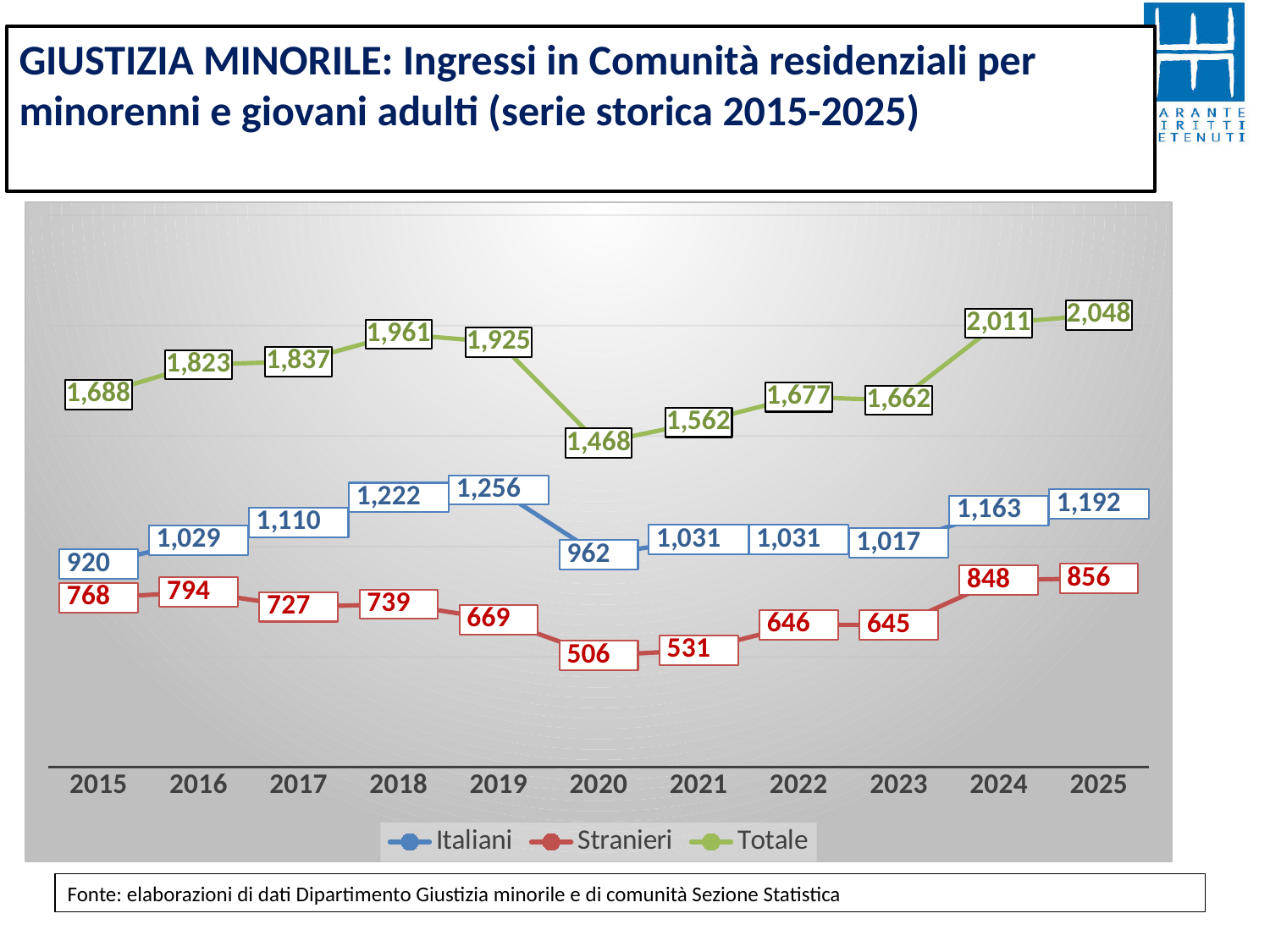
Does the Totale series rise or fall from 2023 to 2025? Rise What is the value for Totale in 2025? 2,048 How many series does the legend list? 3 In which year is the Totale series lowest? 2020 How many years are shown on the x axis? 11 What is the value for Stranieri in 2020? 506 What is the value for Italiani in 2019? 1,256 Which is larger, the Stranieri value in 2016 or in 2017? 2016 What kind of chart is shown on the slide? Line chart What is the difference between the Italiani values in 2019 and 2020? 294 In which year is the Stranieri series highest? 2025 Which colour is used for the Stranieri series? Red